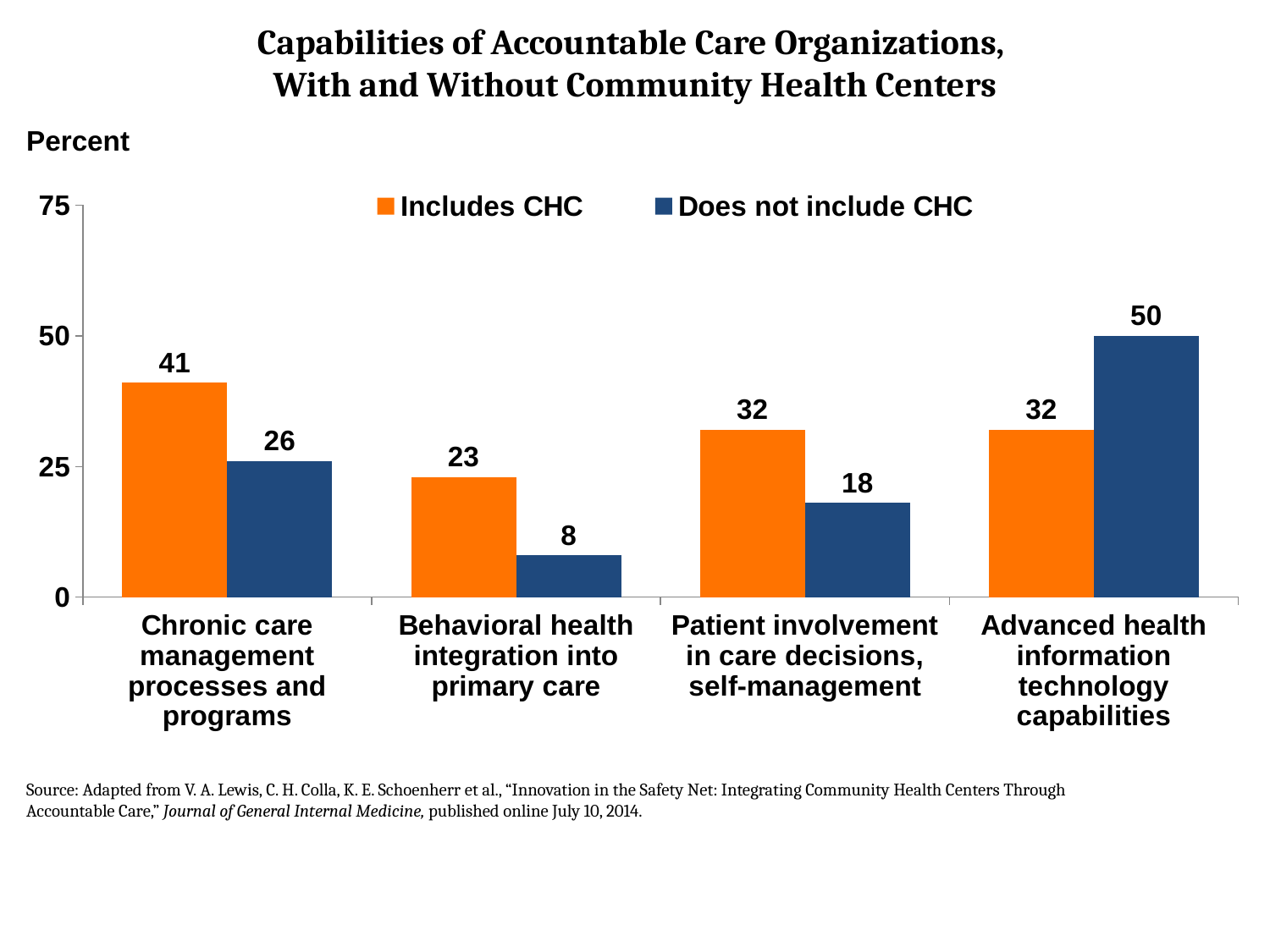
Which category has the highest value for "Does not include CHC"? Advanced health information technology capabilities Which category has the lowest value for "Includes CHC"? Behavioral health integration into primary care What kind of chart is shown on the slide? Bar chart What colour are the bars for the "Includes CHC" series? Orange What is the value for "Does not include CHC" for Advanced health information technology capabilities? 50 What is the value for "Does not include CHC" for Behavioral health integration into primary care? 8 How many series does the legend list? 2 How many categories are shown on the x axis? 4 Is the "Includes CHC" value for Chronic care management processes and programs greater or less than 50? less What is the value for "Includes CHC" for Chronic care management processes and programs? 41 For Advanced health information technology capabilities, which series has the larger value: "Includes CHC" or "Does not include CHC"? Does not include CHC What is the difference between the "Includes CHC" and "Does not include CHC" values for Patient involvement in care decisions, self-management? 14